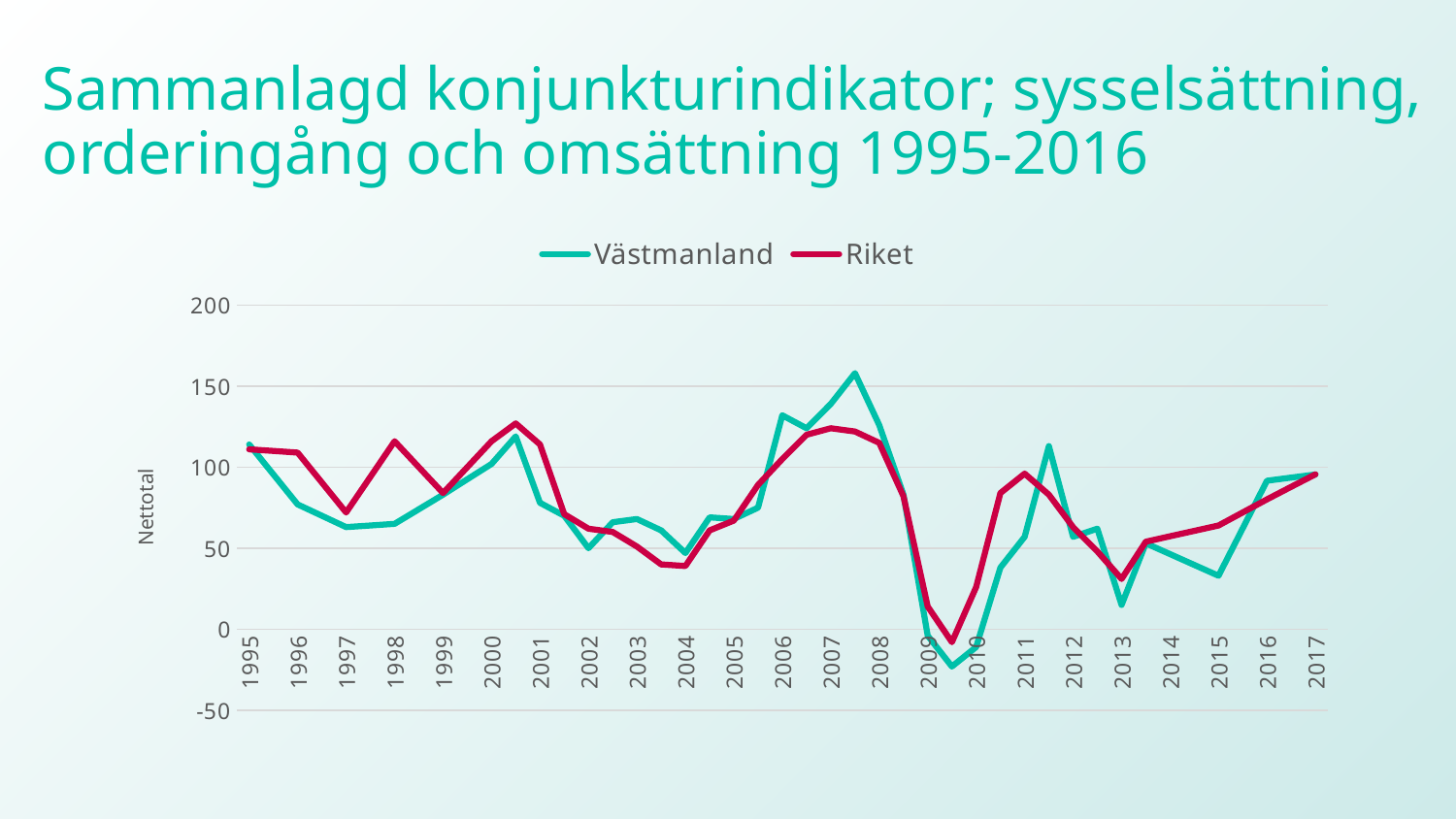
How many year labels are shown along the x axis? 23 Is the value for Riket in 1995 greater or less than 100? greater Does the Riket line rise or fall between 2007 and 2009? fall In 1998, which series has the larger value, Västmanland or Riket? Riket Which series reaches the lowest value anywhere on the chart? Västmanland How many series does the legend list? 2 Which series reaches the highest value anywhere on the chart? Västmanland At the 2007 peak, which series has the larger value, Västmanland or Riket? Västmanland What kind of chart is shown on the slide? line chart What are the two series named in the legend? Västmanland and Riket What is the label on the vertical axis? Nettotal